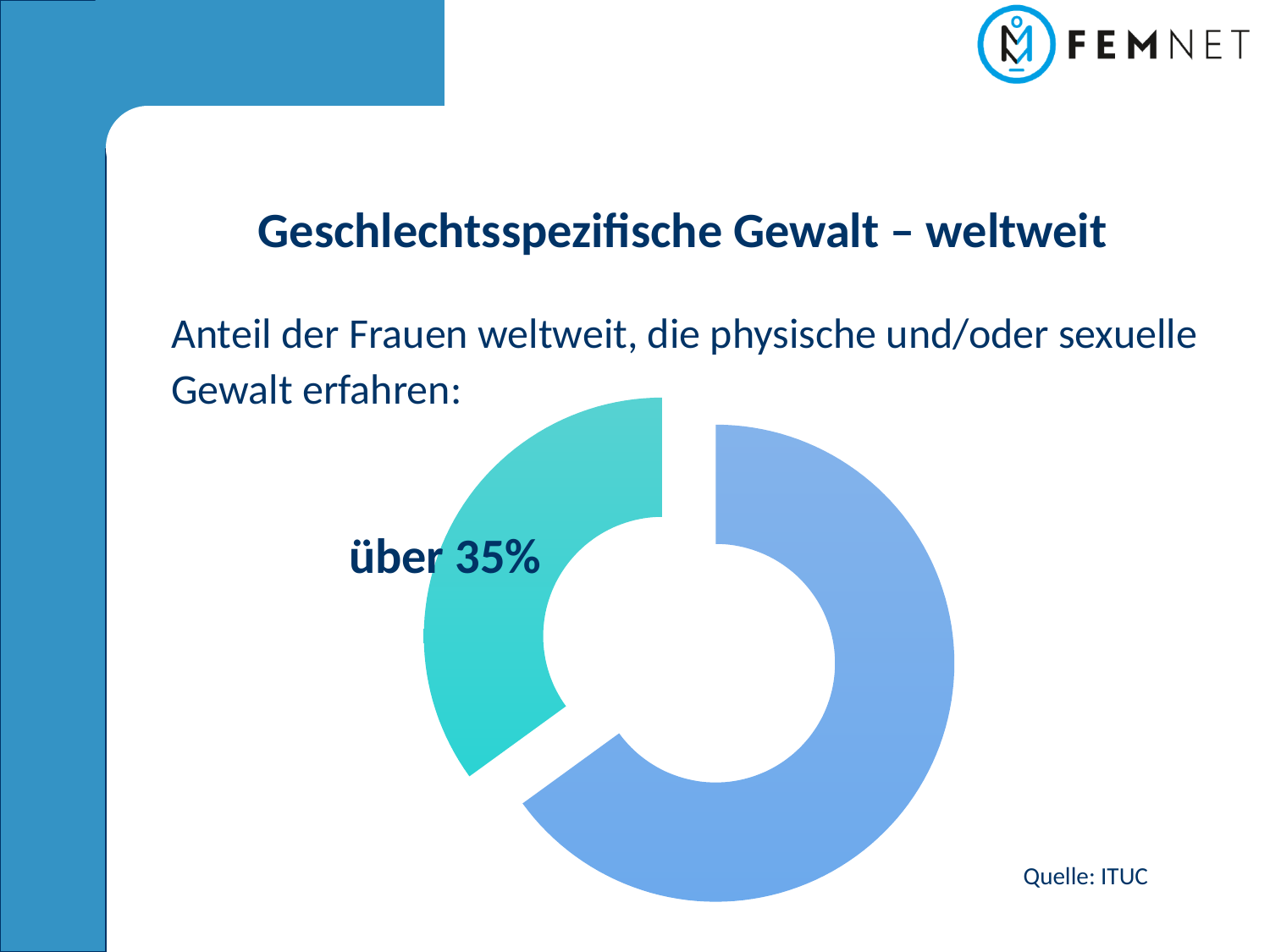
What source is cited for the chart? ITUC How many slices does the doughnut chart have? 2 Is the share of the teal slice greater or less than 50%? less What kind of chart is shown on the slide? doughnut (pie) chart Which slice of the doughnut chart is the smallest? the teal slice (über 35%) What share of women worldwide does the chart say have experienced physical and/or sexual violence? über 35% Which slice of the doughnut chart is larger, the teal one or the blue one? the blue one Is the share of the blue slice greater or less than 50%? greater What value is printed next to the teal slice of the doughnut chart? über 35% What is the title of the slide containing the chart? Geschlechtsspezifische Gewalt – weltweit